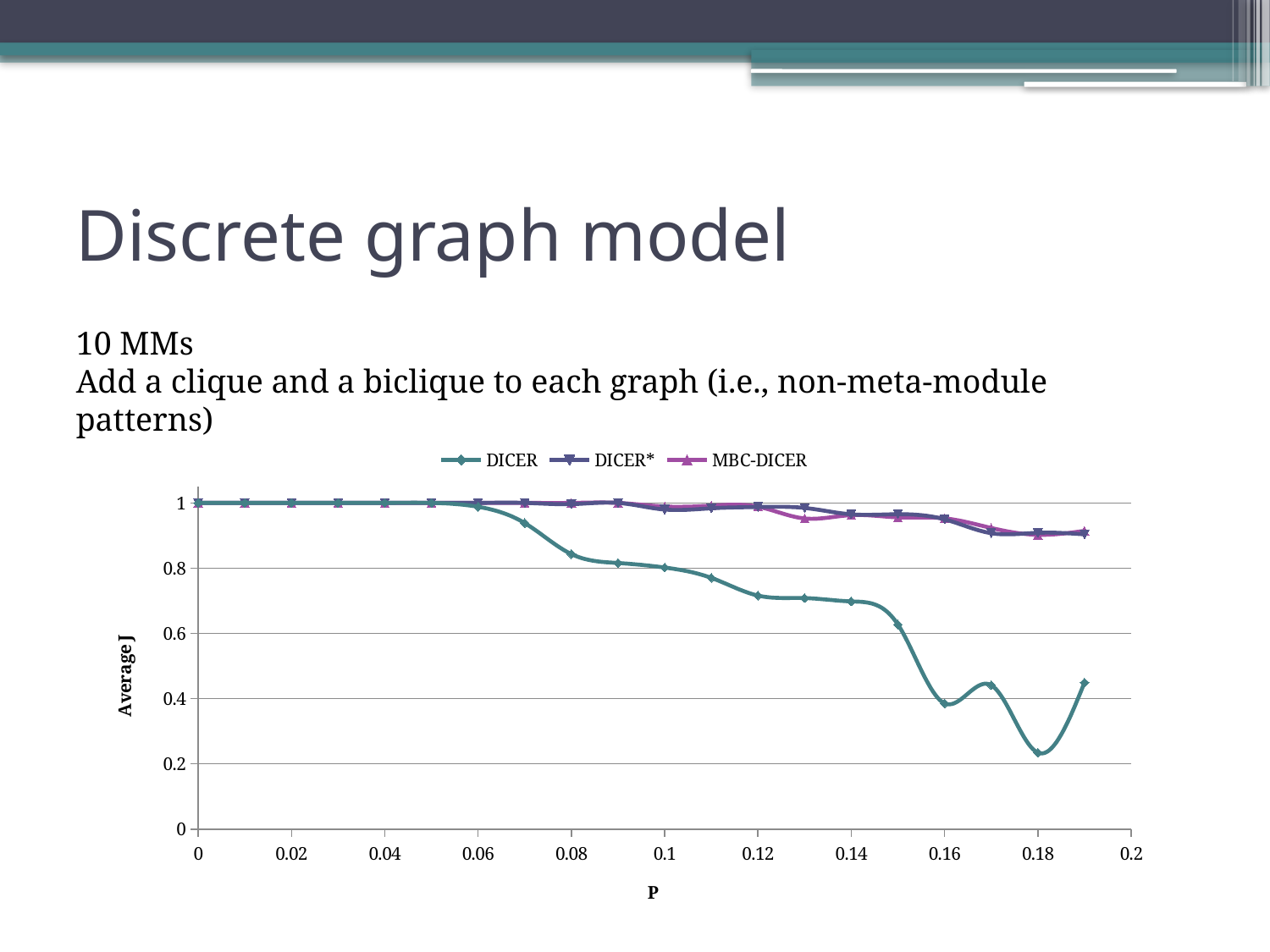
What kind of chart is shown on the slide? line chart What are the three series named in the chart legend? DICER, DICER*, MBC-DICER Is the value for DICER* at P = 0.18 greater or less than 0.8? greater At P = 0.18, which series has the larger value, DICER or DICER*? DICER* What is the label of the chart's vertical axis? Average J Does the DICER series generally rise or fall as P increases from 0 to 0.18? fall How many series does the chart legend list? 3 What is the value of the DICER series at P = 0? 1 Is the value for DICER at P = 0.16 greater or less than 0.6? less Is the value for DICER at P = 0.12 greater or less than 0.6? greater Which series has the lowest value at P = 0.18? DICER